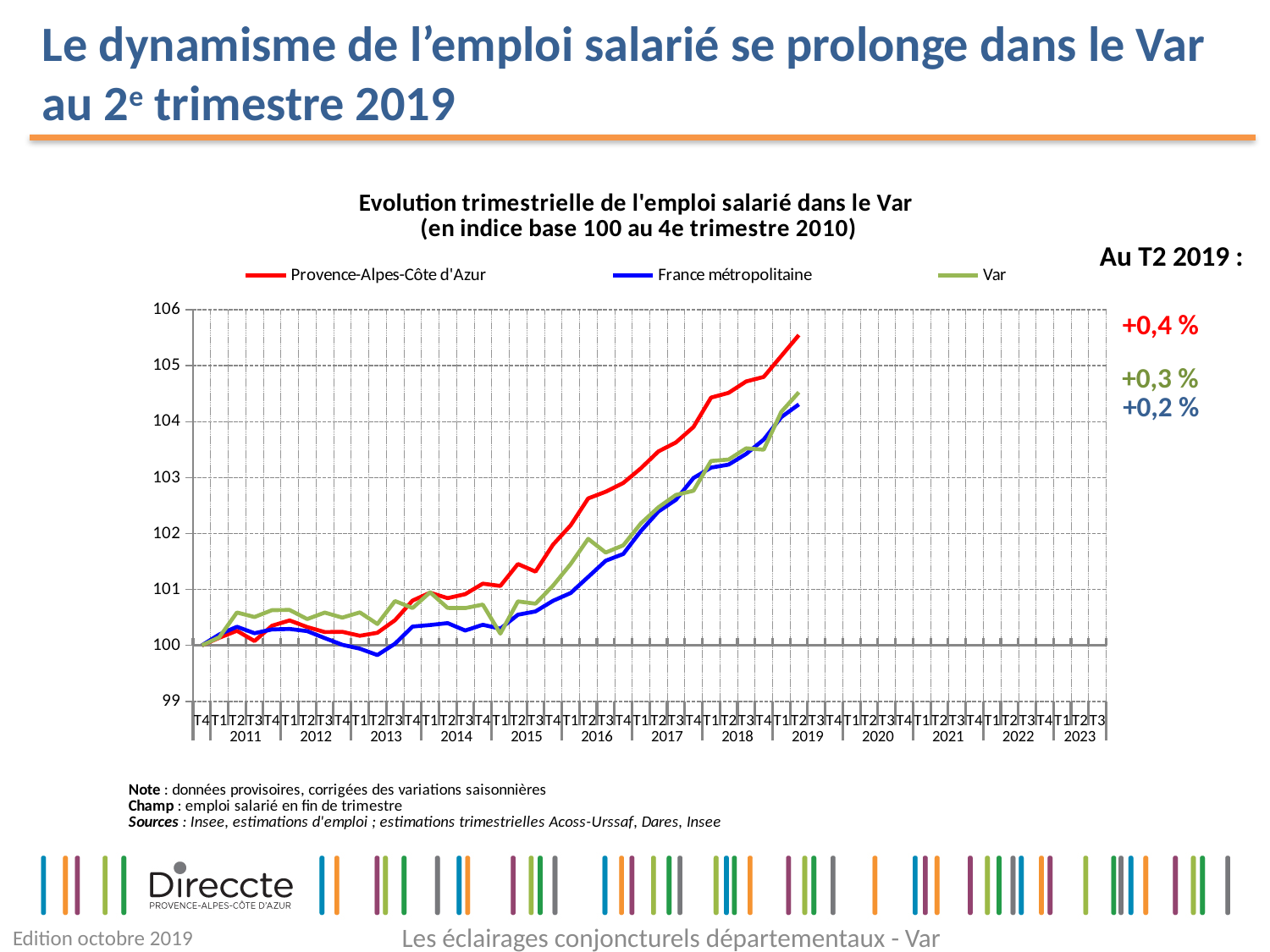
How many series does the legend list? 3 What is the index value of all three series at T4 2010? 100 Is the value for France métropolitaine at T2 2019 greater or less than 105? less What quarterly change is shown for Provence-Alpes-Côte d'Azur at T2 2019? +0,4 % Which series has the highest index value at T2 2019? Provence-Alpes-Côte d'Azur What is the title of the chart? Evolution trimestrielle de l'emploi salarié dans le Var (en indice base 100 au 4e trimestre 2010) What quarterly change is shown for France métropolitaine at T2 2019? +0,2 % Is the value for Provence-Alpes-Côte d'Azur at T2 2019 greater or less than 105? greater What kind of chart is shown on the slide? line chart What quarterly change is shown for Var at T2 2019? +0,3 % Which series has the lowest index value at T2 2013? France métropolitaine Which colour is used for the Var series? green